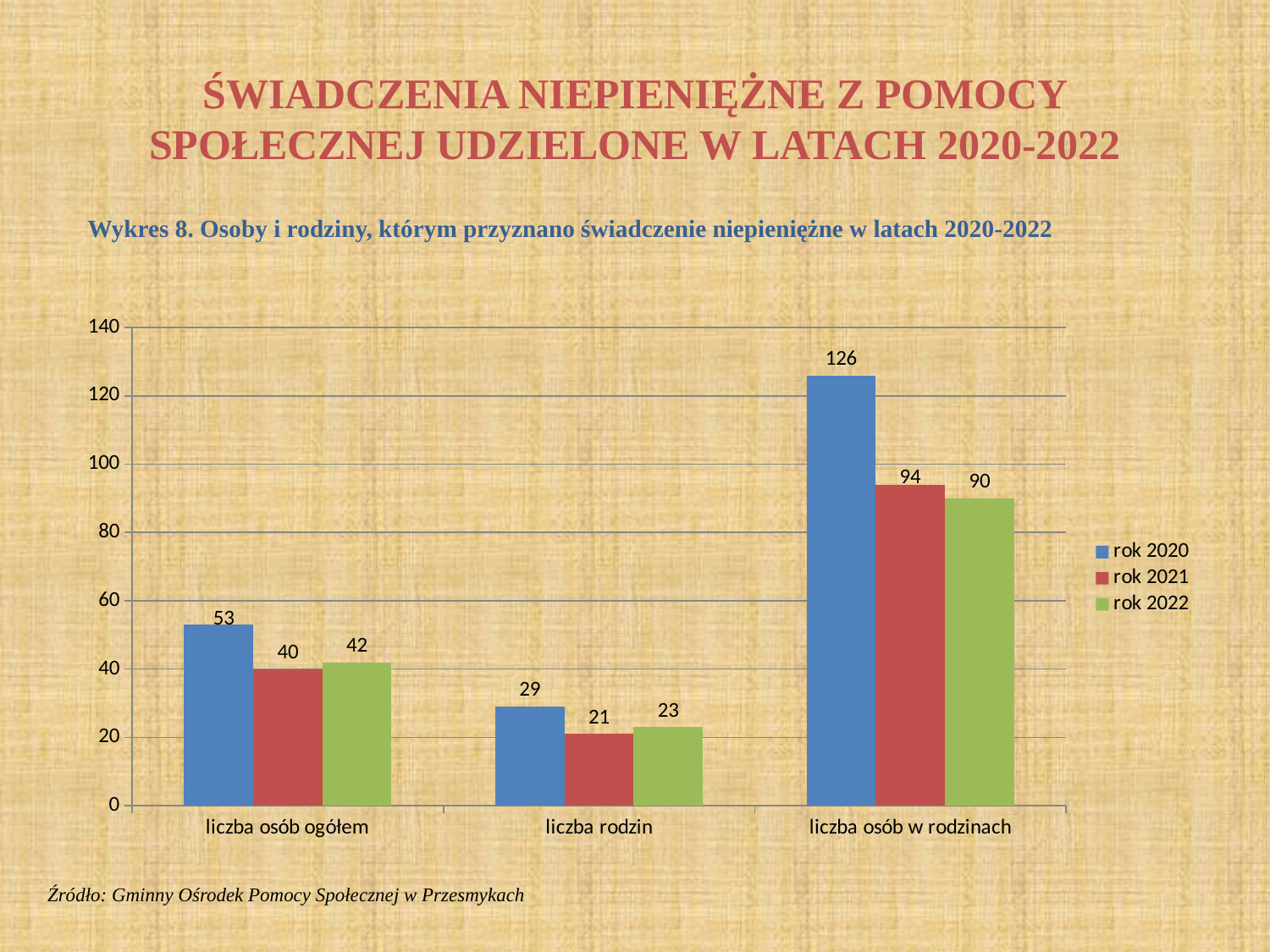
What is the difference between the 'rok 2020' and 'rok 2021' values in the 'liczba osób w rodzinach' category? 32 What is the value for 'rok 2021' in the 'liczba rodzin' category? 21 Which category has the highest value for 'rok 2020'? liczba osób w rodzinach Which series has the lowest value in the 'liczba rodzin' category? rok 2021 What is the value for 'rok 2020' in the 'liczba osób ogółem' category? 53 Which is larger in the 'liczba osób ogółem' category: 'rok 2021' or 'rok 2022'? rok 2022 What kind of chart is shown on the slide? bar chart Is the value for 'rok 2020' in 'liczba osób w rodzinach' greater or less than 120? greater What is the title of the chart (Wykres 8)? Osoby i rodziny, którym przyznano świadczenie niepieniężne w latach 2020-2022 How many series does the legend list? 3 What is the value for 'rok 2022' in the 'liczba osób w rodzinach' category? 90 How many categories are shown on the x axis? 3